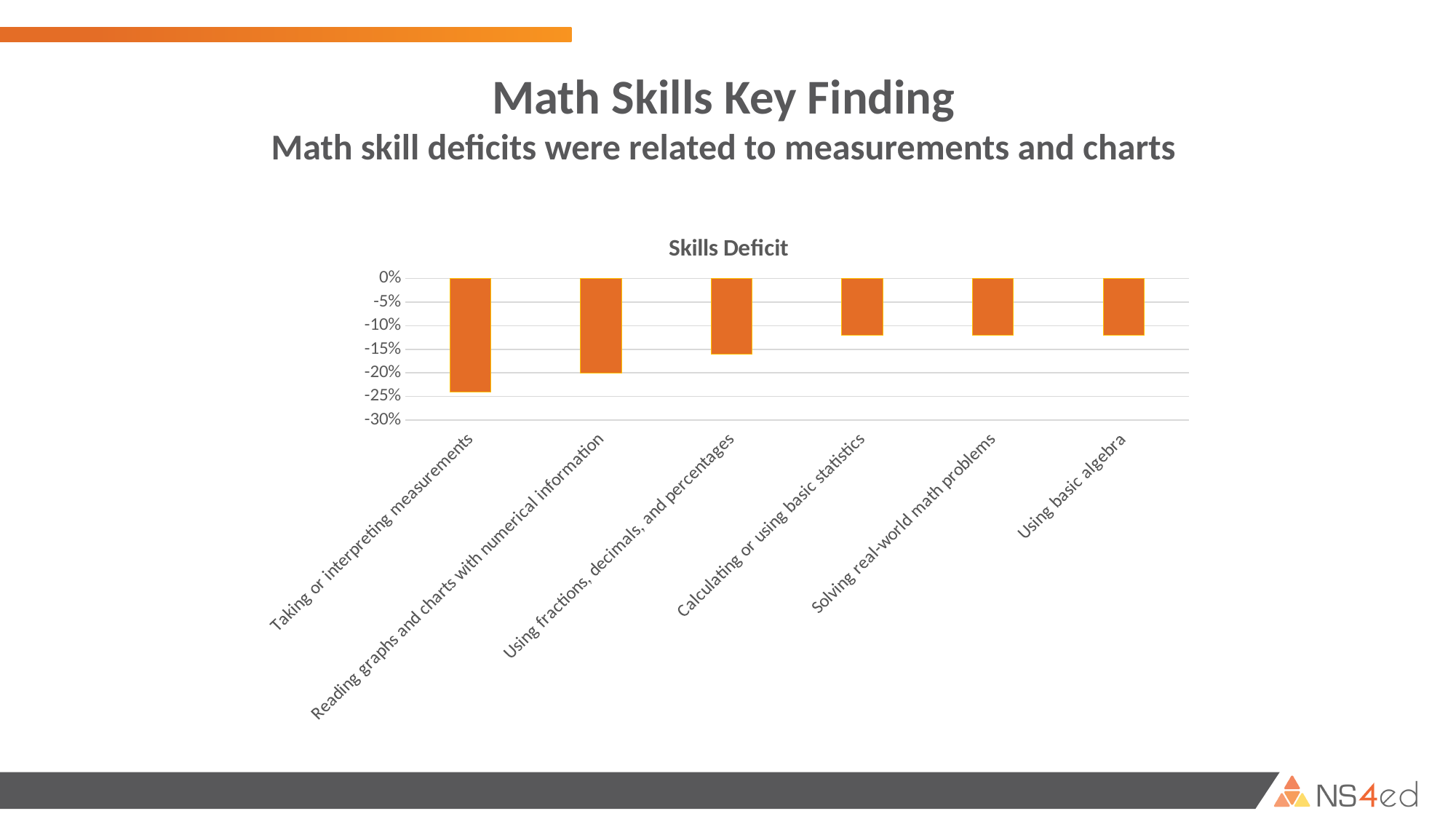
Is the value for Calculating or using basic statistics greater or less than -15%? greater How many categories are shown in the Skills Deficit chart? 6 What type of chart is shown on the slide? bar chart Is the value for Using fractions, decimals, and percentages greater or less than -20%? greater Is the value for Using basic algebra greater or less than -10%? less What is the title of the chart? Skills Deficit Do the values generally rise or fall moving from left to right across the categories? rise What colour are the bars in the chart? orange Which has the lower (more negative) value: Reading graphs and charts with numerical information or Using fractions, decimals, and percentages? Reading graphs and charts with numerical information Which category has the lowest (most negative) value in the chart? Taking or interpreting measurements What is the value for Reading graphs and charts with numerical information? -20%